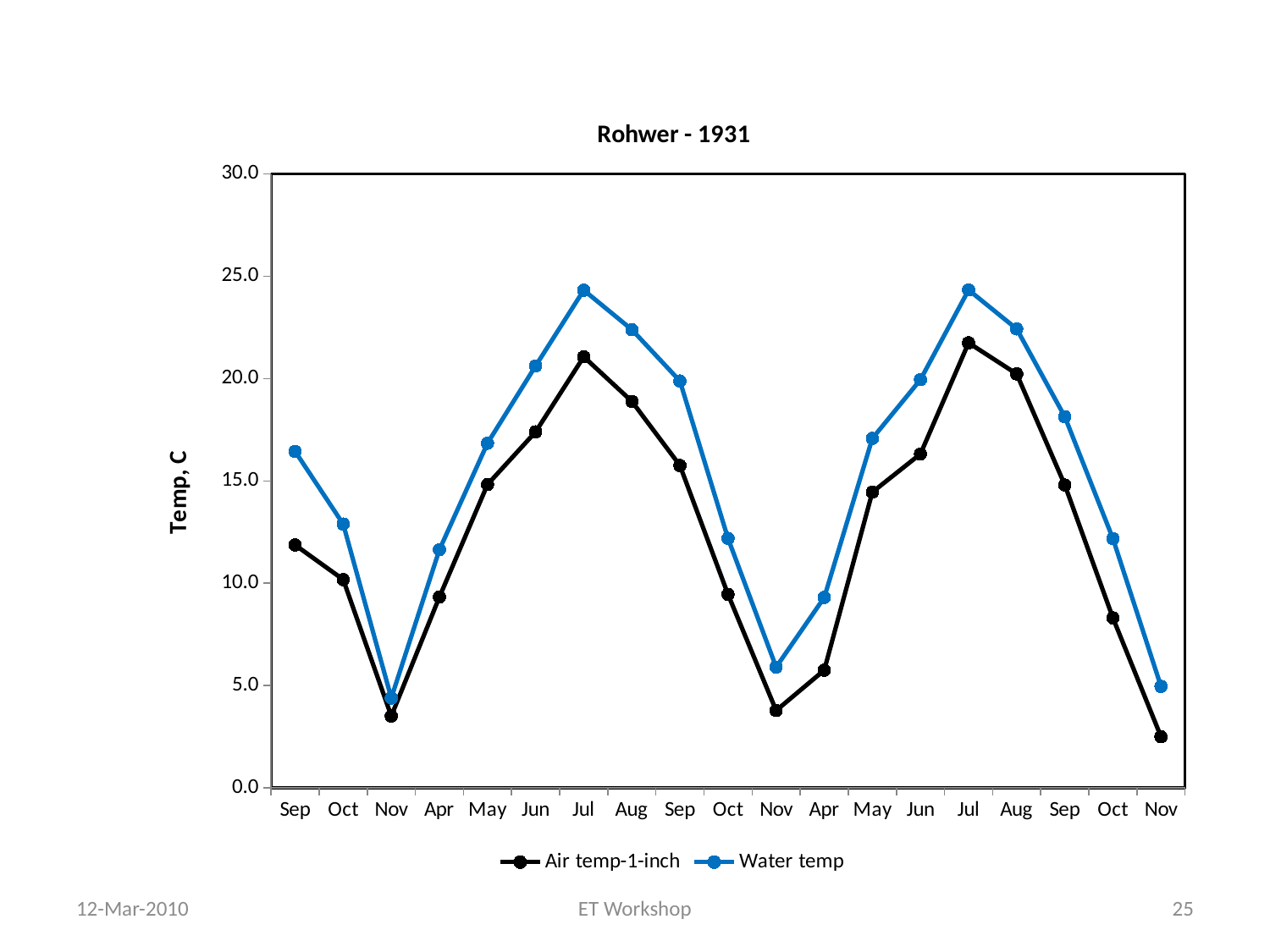
Is the Air temp-1-inch value at the second Jul greater or less than 20.0? greater How many series does the legend list? 2 What is the title of the chart? Rohwer - 1931 How many points are plotted along the x axis for each series? 19 Is the Air temp-1-inch value at the first Nov greater or less than 5.0? less What type of chart is shown on the slide? line chart Is the Water temp value at the first Jul greater or less than 20.0? greater Which month label has the lowest Air temp-1-inch value on the chart? the last Nov At the first Sep, which series has the higher value, Air temp-1-inch or Water temp? Water temp Which series is drawn in blue? Water temp Do the values rise or fall from the second Jul to the last Nov for the Water temp series? fall